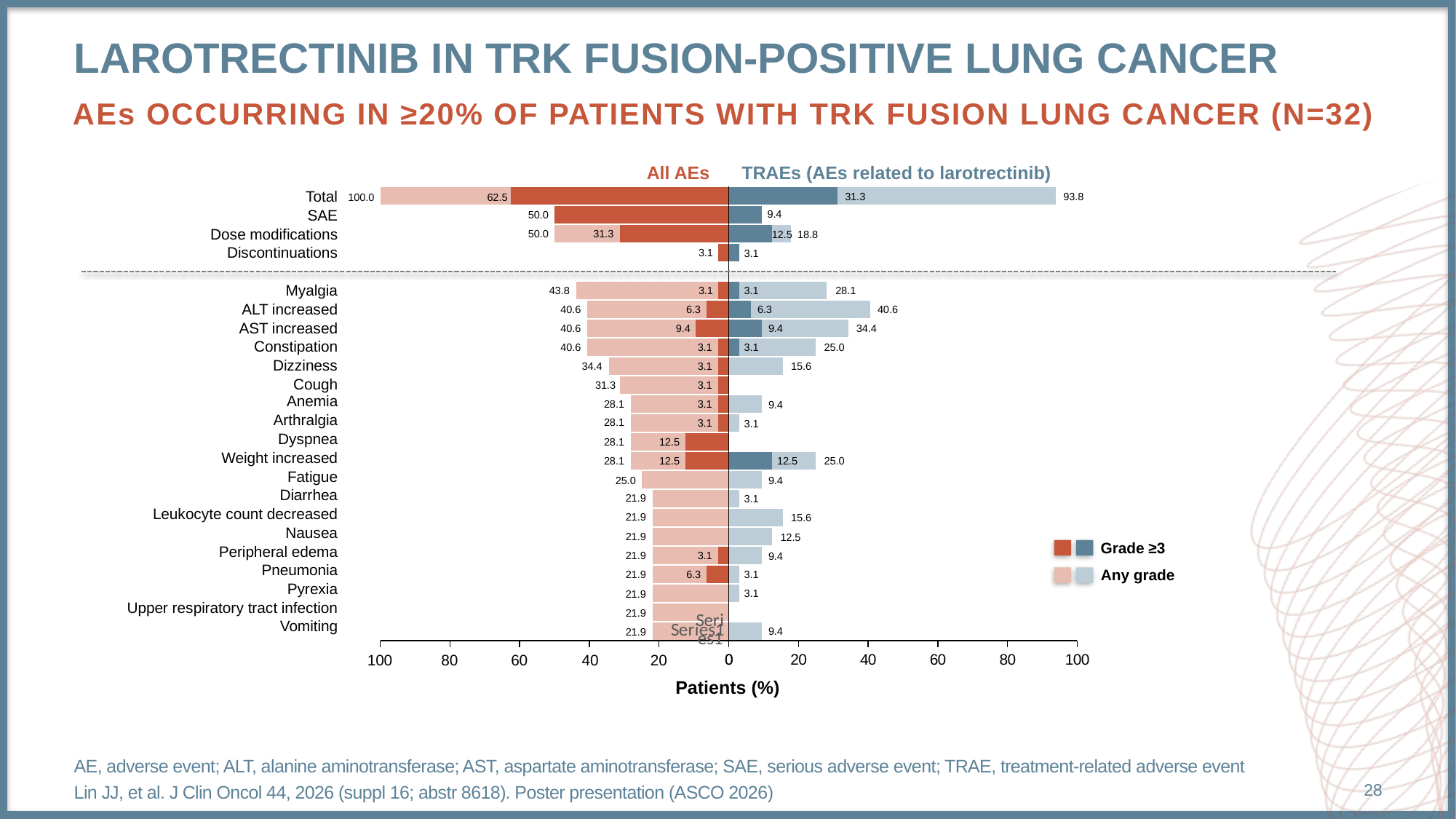
What is the any-grade TRAEs value for Total? 93.8 What is the any-grade TRAEs value for ALT increased? 40.6 What is the title of the x axis? Patients (%) How many adverse events are listed below the dashed line? 19 How many series does the legend list? 2 What is the difference between the any-grade All AEs value for AST increased and its any-grade TRAEs value? 6.2 What kind of chart is shown on the slide? Bar chart Which adverse event below the dashed line has the highest any-grade All AEs value? Myalgia What is the Grade ≥3 TRAEs value for Weight increased? 12.5 Which is larger: the any-grade TRAEs value for Constipation or for Dizziness? Constipation What is the Grade ≥3 All AEs value for Total? 62.5 What is the any-grade All AEs value for Myalgia? 43.8